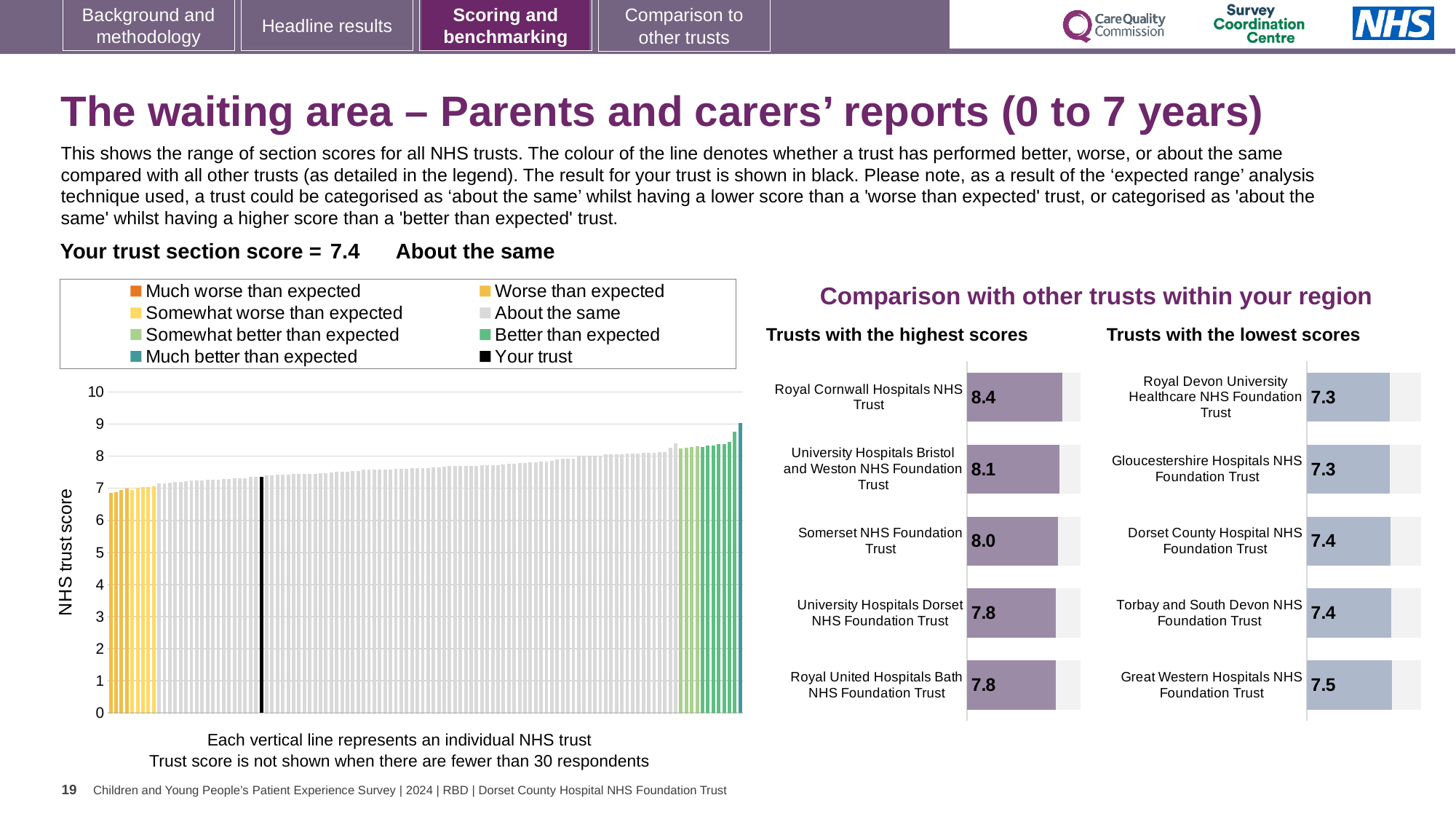
What kind of chart is the main chart on the left showing NHS trust scores? bar chart In the 'Trusts with the lowest scores' chart, what is the score for Great Western Hospitals NHS Foundation Trust? 7.5 In the main chart on the left, what is the section score for your trust (the black bar)? 7.4 Which has the larger score: Somerset NHS Foundation Trust in the 'Trusts with the highest scores' chart or Great Western Hospitals NHS Foundation Trust in the 'Trusts with the lowest scores' chart? Somerset NHS Foundation Trust In the main chart on the left, do the bar values rise or fall from left to right? rise In the 'Trusts with the highest scores' chart, what is the score for Royal Cornwall Hospitals NHS Trust? 8.4 How many trusts are shown in the 'Trusts with the lowest scores' chart? 5 In the 'Trusts with the highest scores' chart, what is the difference between the scores of Royal Cornwall Hospitals NHS Trust and Somerset NHS Foundation Trust? 0.4 How many entries does the legend above the main chart on the left list? 8 In the main chart on the left, is the value of the tallest bar greater or less than 8? greater In the 'Trusts with the lowest scores' chart, what is the difference between the scores of Great Western Hospitals NHS Foundation Trust and Gloucestershire Hospitals NHS Foundation Trust? 0.2 In the 'Trusts with the highest scores' chart, which trust has the highest score? Royal Cornwall Hospitals NHS Trust